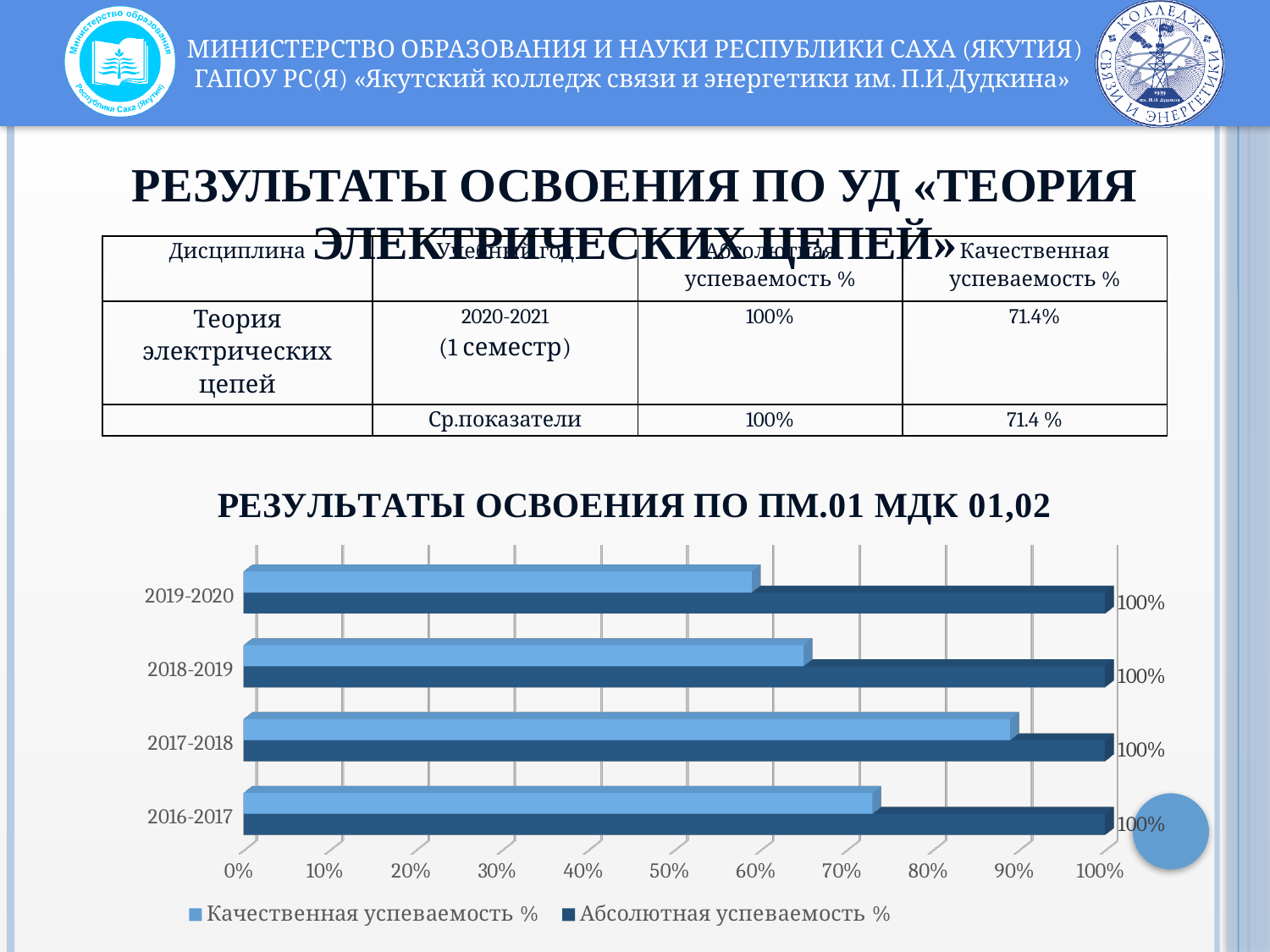
Which academic year has the lowest Качественная успеваемость %? 2019-2020 How many series does the chart legend list? 2 Is the value of Качественная успеваемость % for 2019-2020 greater or less than 70%? less Is the value of Качественная успеваемость % for 2017-2018 greater or less than 80%? greater Which is larger: Качественная успеваемость % for 2017-2018 or for 2016-2017? 2017-2018 What kind of chart is shown on the slide? bar chart What is the value of Абсолютная успеваемость % for 2016-2017? 100% What is the title of the chart? РЕЗУЛЬТАТЫ ОСВОЕНИЯ ПО ПМ.01 МДК 01,02 How many academic years (categories) are shown in the chart? 4 Which academic year has the highest Качественная успеваемость %? 2017-2018 What is the value of Абсолютная успеваемость % for 2019-2020? 100% Is the value of Качественная успеваемость % for 2016-2017 greater or less than 70%? greater